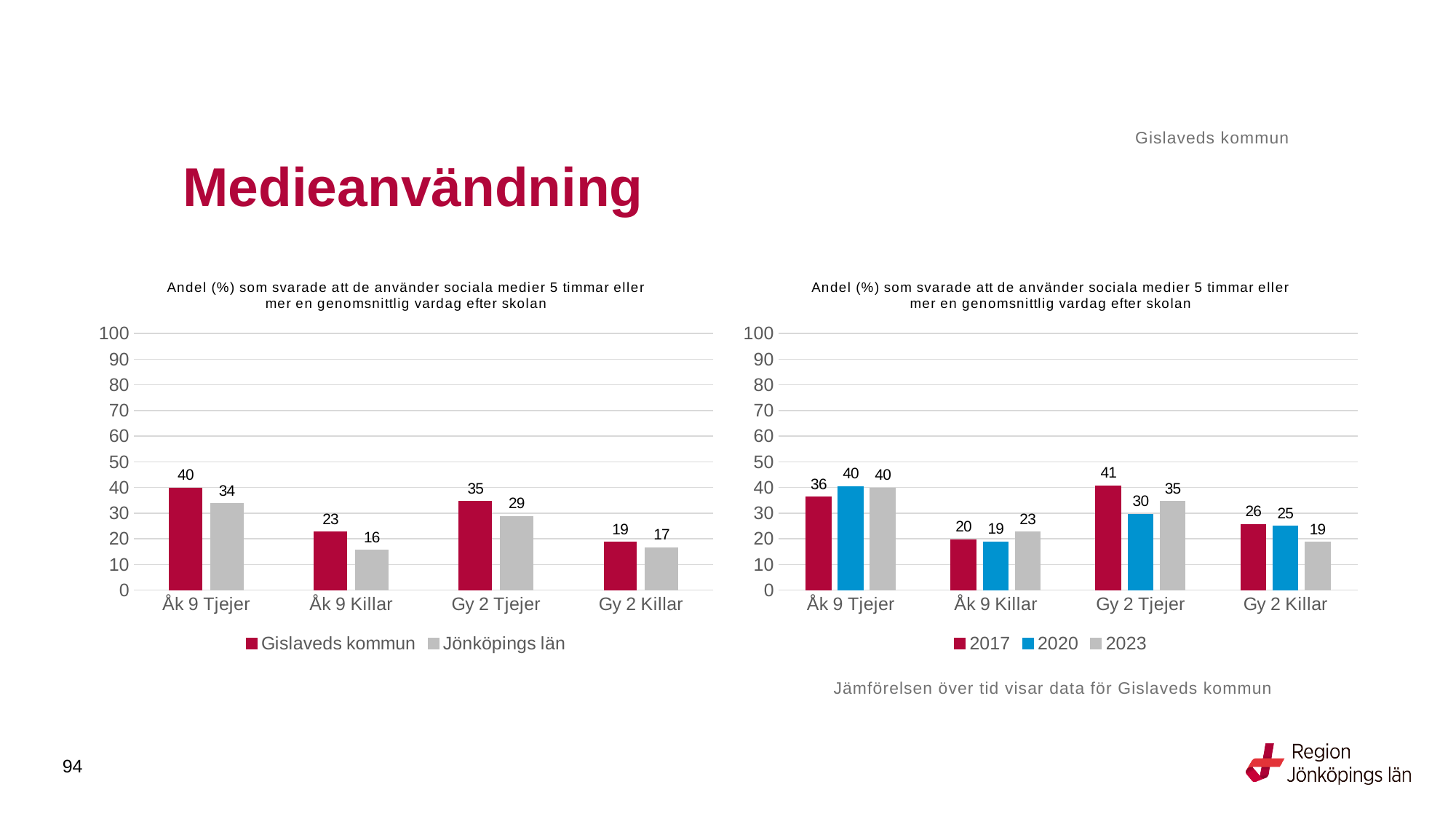
In the right chart, which is larger for Åk 9 Killar: 2017 or 2023? 2023 In the left chart, what is the value for Jönköpings län for Åk 9 Killar? 16 In the right chart, what is the value for 2020 for Gy 2 Tjejer? 30 In the left chart, what is the value for Gislaveds kommun for Åk 9 Tjejer? 40 In the right chart, what is the value for 2023 for Gy 2 Killar? 19 In the left chart, which category has the lowest value for Jönköpings län? Åk 9 Killar In the left chart, what is the difference between Gislaveds kommun and Jönköpings län for Gy 2 Tjejer? 6 In the left chart, which category has the highest value for Gislaveds kommun? Åk 9 Tjejer In the right chart, how many categories are shown on the x axis? 4 In the left chart, how many series does the legend list? 2 In the right chart, what is the difference between 2017 and 2023 for Gy 2 Tjejer? 6 What type of chart is the right chart? Bar chart